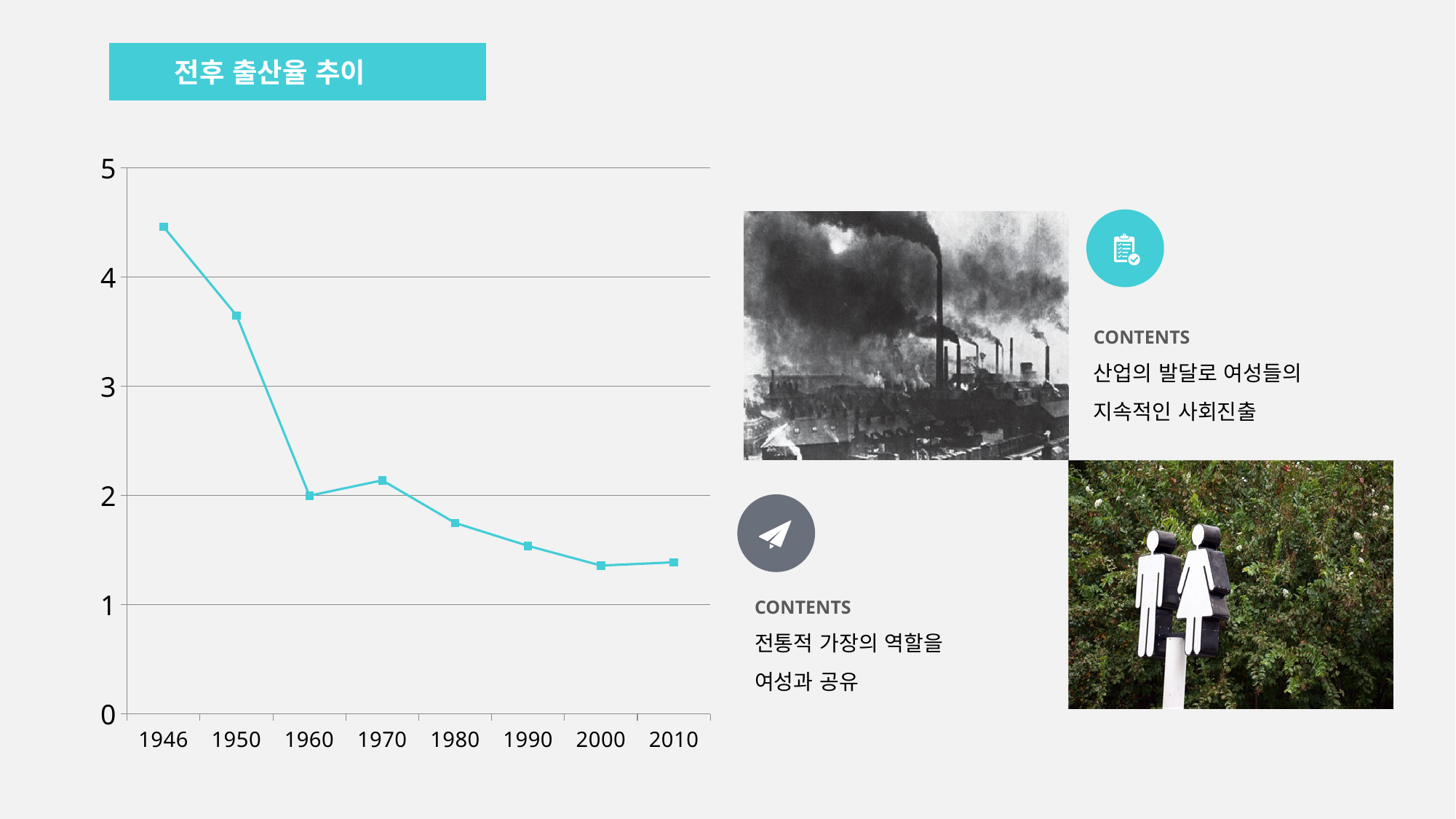
Is the value for 1980 greater or less than 2? less Which is larger, the value for 1960 or the value for 1970? 1970 Is the value for 1960 greater or less than 3? less Is the value for 2000 greater or less than 1? greater What kind of chart is shown on the slide? line chart Which is larger, the value for 1946 or the value for 1950? 1946 Which year has the highest value in the chart? 1946 What is the title of the chart? 전후 출산율 추이 How many years are plotted on the x axis of the chart? 8 Overall, do the values rise or fall from 1946 to 2010? fall